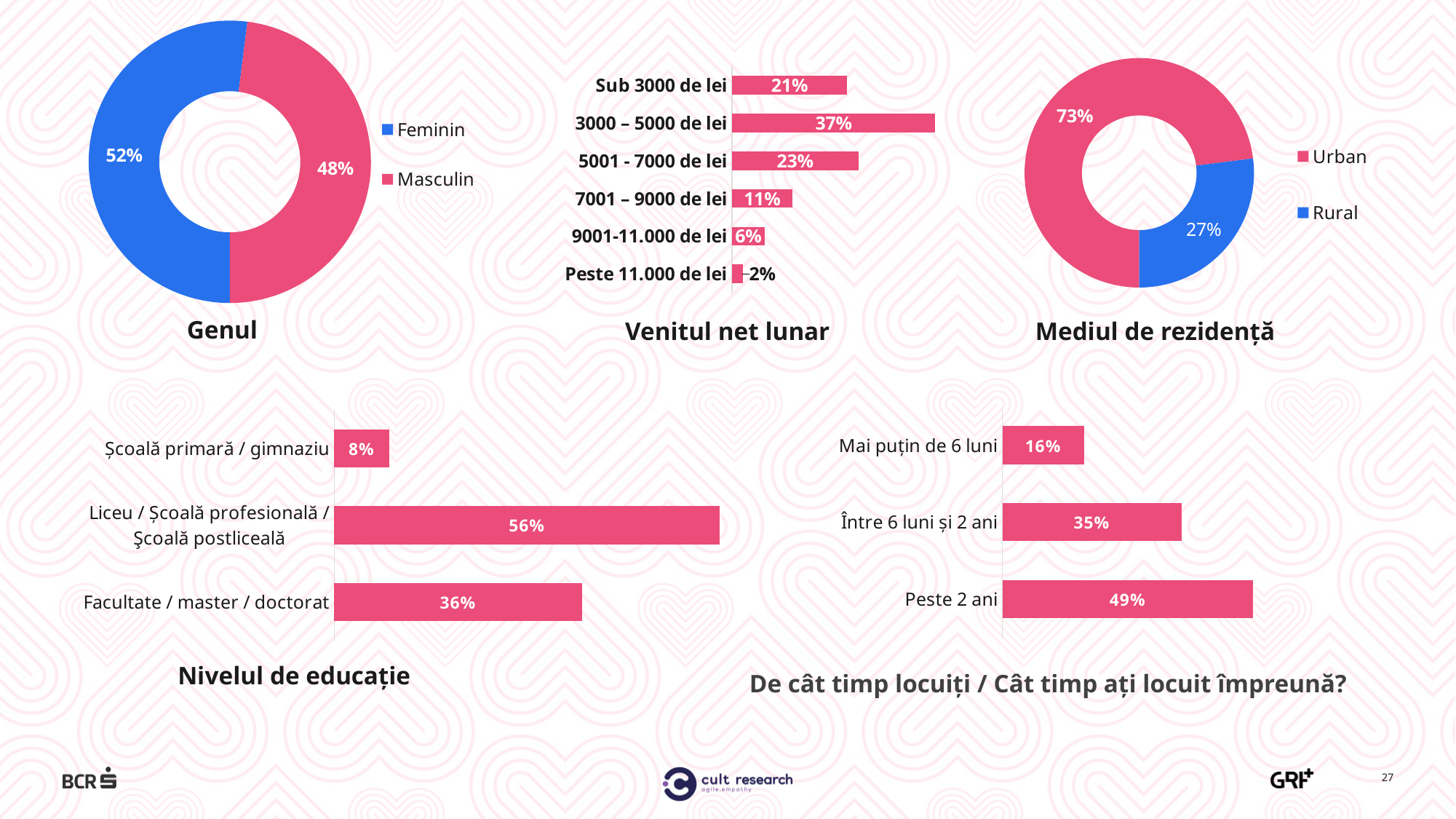
In the 'De cât timp locuiți / Cât timp ați locuit împreună?' chart, do the values rise or fall from top to bottom? Rise In the 'Mediul de rezidență' chart, what share is Rural? 27% In the 'Nivelul de educație' chart, what is the value for 'Facultate / master / doctorat'? 36% In the 'Genul' chart, what kind of chart is shown? Doughnut chart In the 'De cât timp locuiți / Cât timp ați locuit împreună?' chart, what is the value for 'Peste 2 ani'? 49% In the 'Venitul net lunar' chart, which category has the lowest value? Peste 11.000 de lei In the 'Genul' chart, what share is Feminin? 52% In the 'Venitul net lunar' chart, what is the value for '3000 – 5000 de lei'? 37% In the 'Venitul net lunar' chart, what is the difference between 'Sub 3000 de lei' and '7001 – 9000 de lei'? 10% In the 'Nivelul de educație' chart, which category has the highest value? Liceu / Școală profesională / Școală postliceală In the 'Mediul de rezidență' chart, which is larger, Urban or Rural? Urban In the 'Venitul net lunar' chart, how many categories are shown? 6